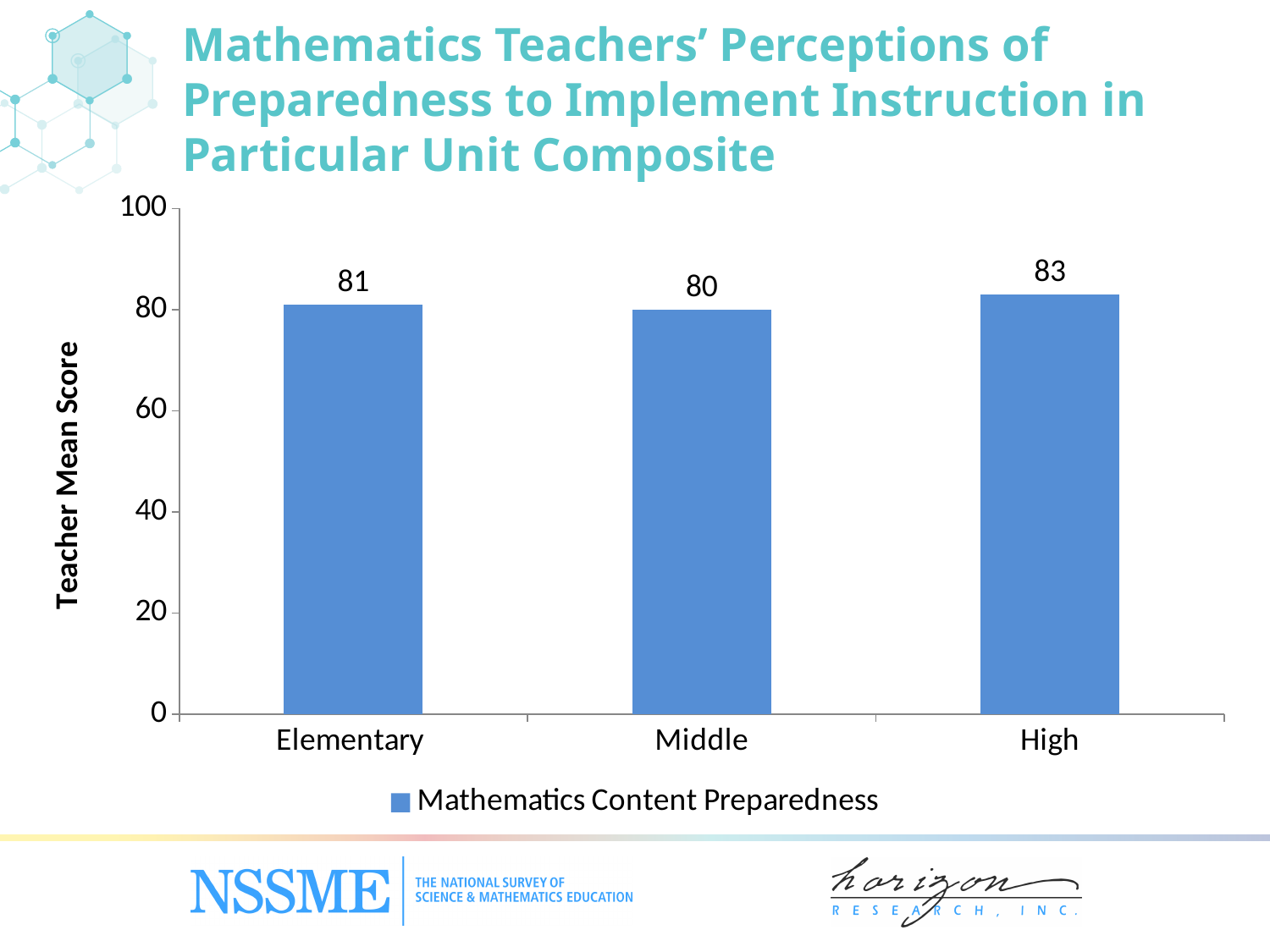
Which grade level has the lowest teacher mean score? Middle What is the label of the y axis? Teacher Mean Score What is the difference between the teacher mean scores for High and Middle? 3 What is the teacher mean score for Elementary? 81 What is the difference between the teacher mean scores for Elementary and Middle? 1 What kind of chart is shown on the slide? Bar chart How many grade-level categories are shown on the x axis? 3 How many series does the legend list? 1 Is the value for High greater or less than 80? greater What is the teacher mean score for High? 83 Which grade level has the highest teacher mean score? High What is the teacher mean score for Middle? 80